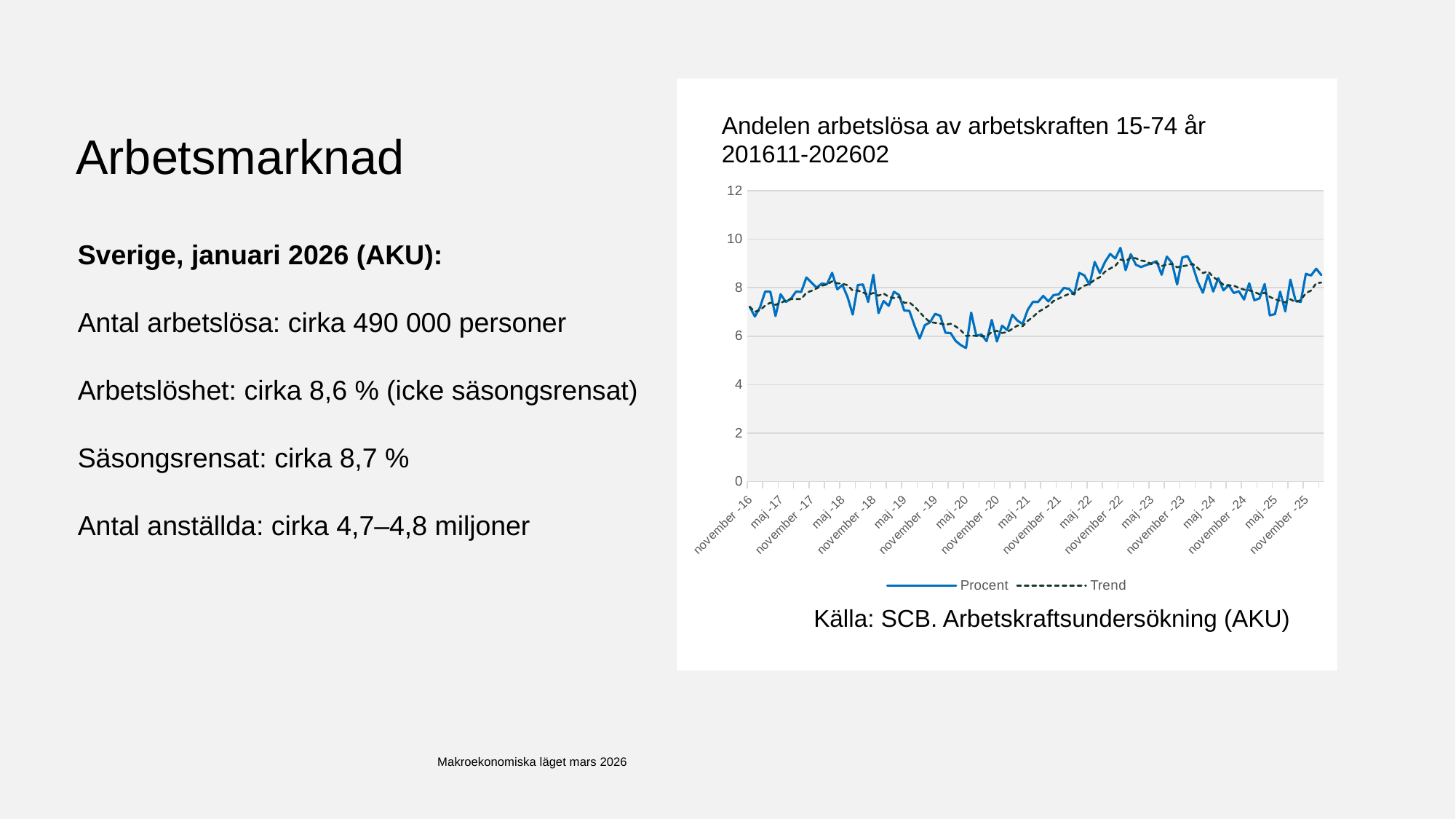
What are the two series named in the chart legend? Procent and Trend Is the Procent value at maj -25 greater or less than 8? less Which is larger, the Procent value at maj -20 or at november -22? november -22 Is the Procent value at maj -20 greater or less than 6? less Does the Procent line rise or fall between maj -20 and november -22? rise How many series does the chart legend list? 2 What is the title of the chart? Andelen arbetslösa av arbetskraften 15-74 år 201611-202602 Is the Procent value at november -16 greater or less than 6? greater Does the Procent line rise or fall between maj -19 and maj -20? fall What kind of chart is shown on the slide? line chart